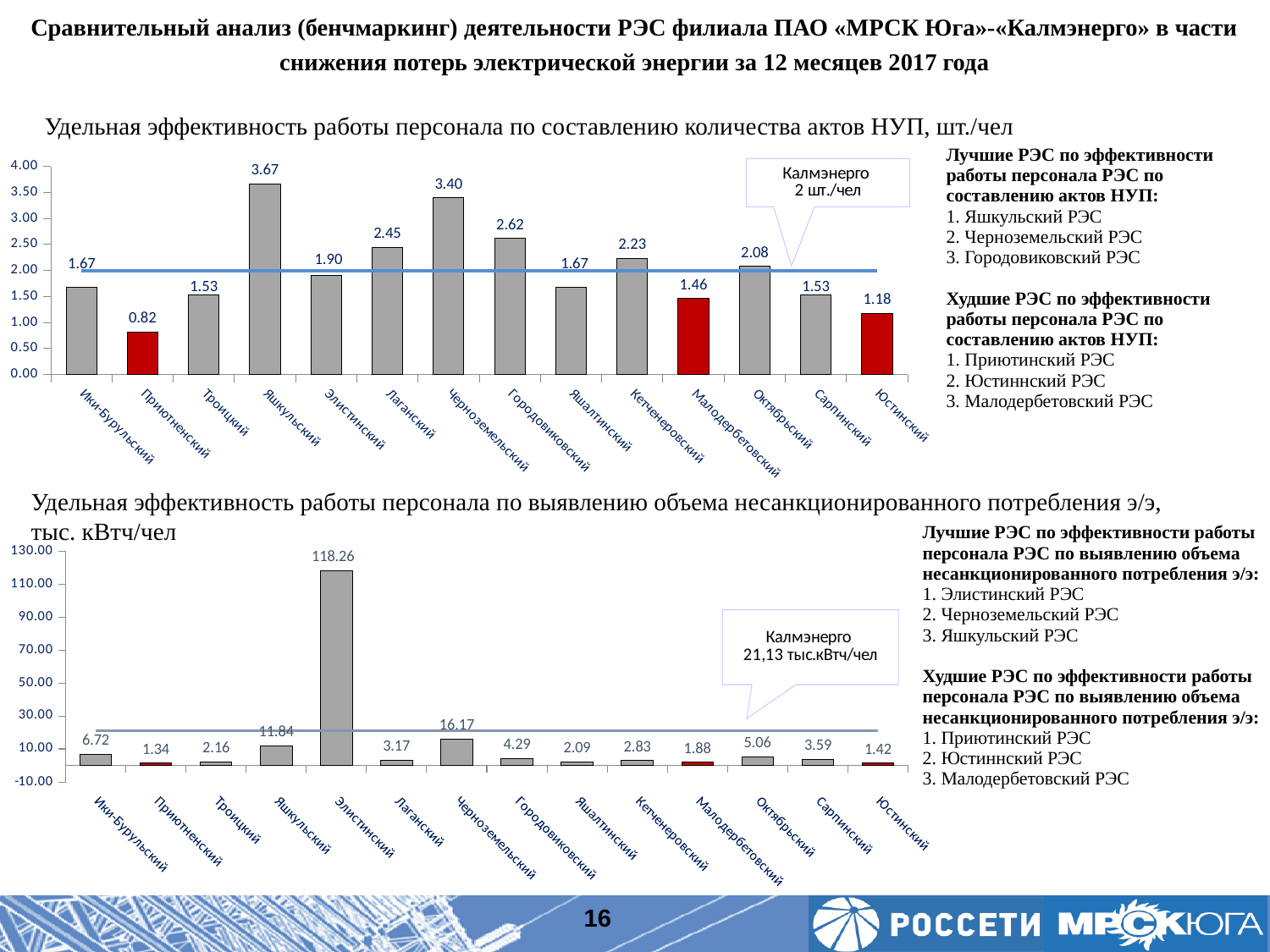
In the top chart, what is the difference between the values for Черноземельский and Городовиковский? 0.78 In the bottom chart, what value does the Калмэнерго reference line mark? 21,13 тыс.кВтч/чел In the top chart, what is the value for Яшкульский? 3.67 What kind of chart is the bottom chart? Bar chart In the top chart, which district has the lowest value? Приютненский In the bottom chart, what is the value for Элистинский? 118.26 In the bottom chart, what is the value for Черноземельский? 16.17 In the bottom chart, which district has the highest value? Элистинский In the top chart, how many districts are shown on the x axis? 14 In the top chart, what value does the Калмэнерго reference line mark? 2 шт./чел In the top chart, which is larger: the value for Лаганский or the value for Кетченеровский? Лаганский In the bottom chart, what is the difference between the values for Ики-Бурульский and Приютненский? 5.38